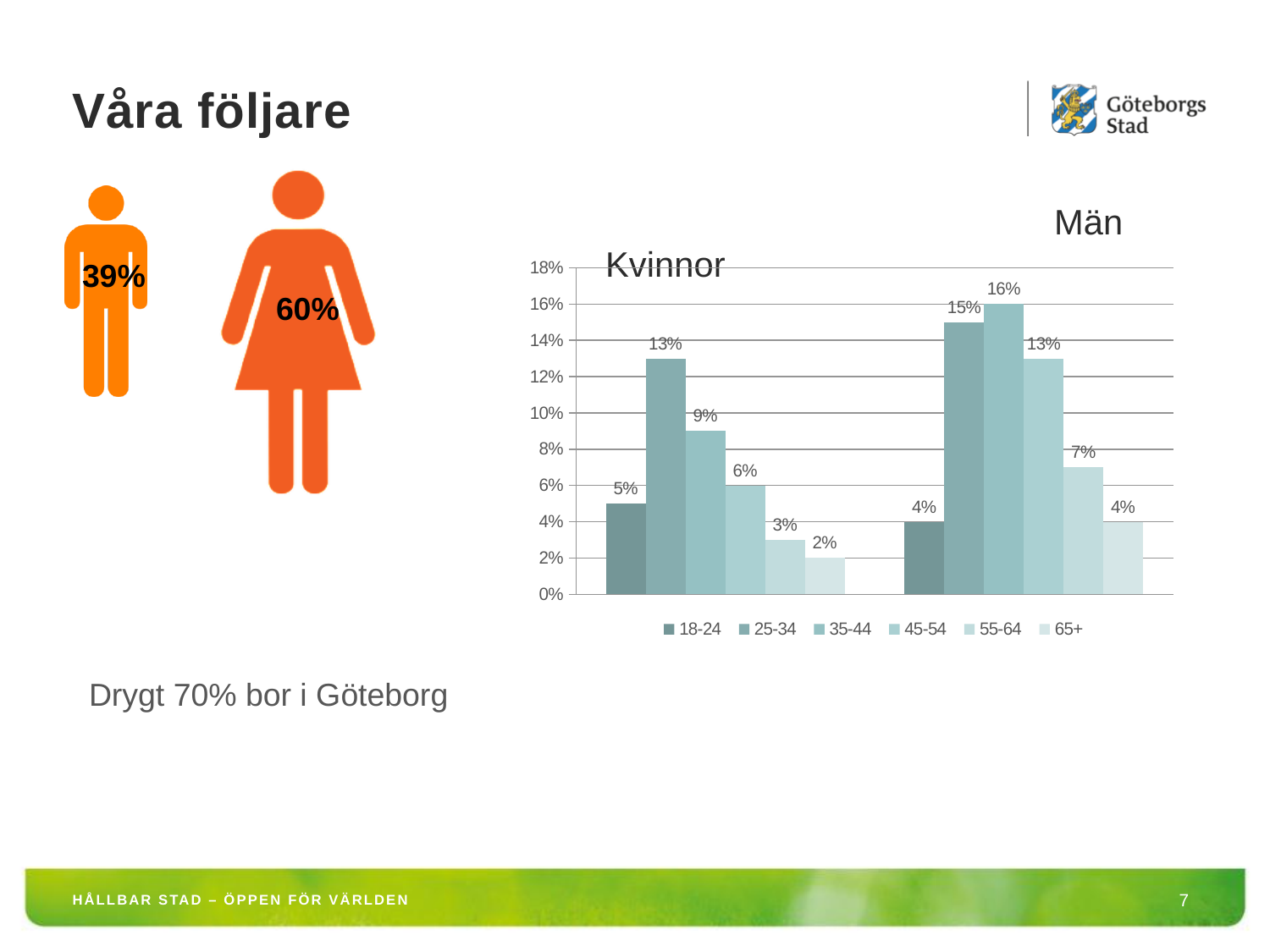
What kind of chart is shown on the slide? bar chart Which is larger: the 45-54 value for Kvinnor or the 45-54 value for Män? Män What is the difference between the 25-34 value for Män and the 25-34 value for Kvinnor? 2% What is the value for the 35-44 age group among Män? 16% How many groups of bars are shown on the x axis? 2 What is the value for the 55-64 age group among Män? 7% What is the difference between the 18-24 value for Kvinnor and the 18-24 value for Män? 1% Which age group has the highest value among Män? 35-44 How many series does the chart legend list? 6 What is the value for the 25-34 age group among Kvinnor? 13% Which age group has the lowest value among Kvinnor? 65+ What is the value for the 65+ age group among Kvinnor? 2%